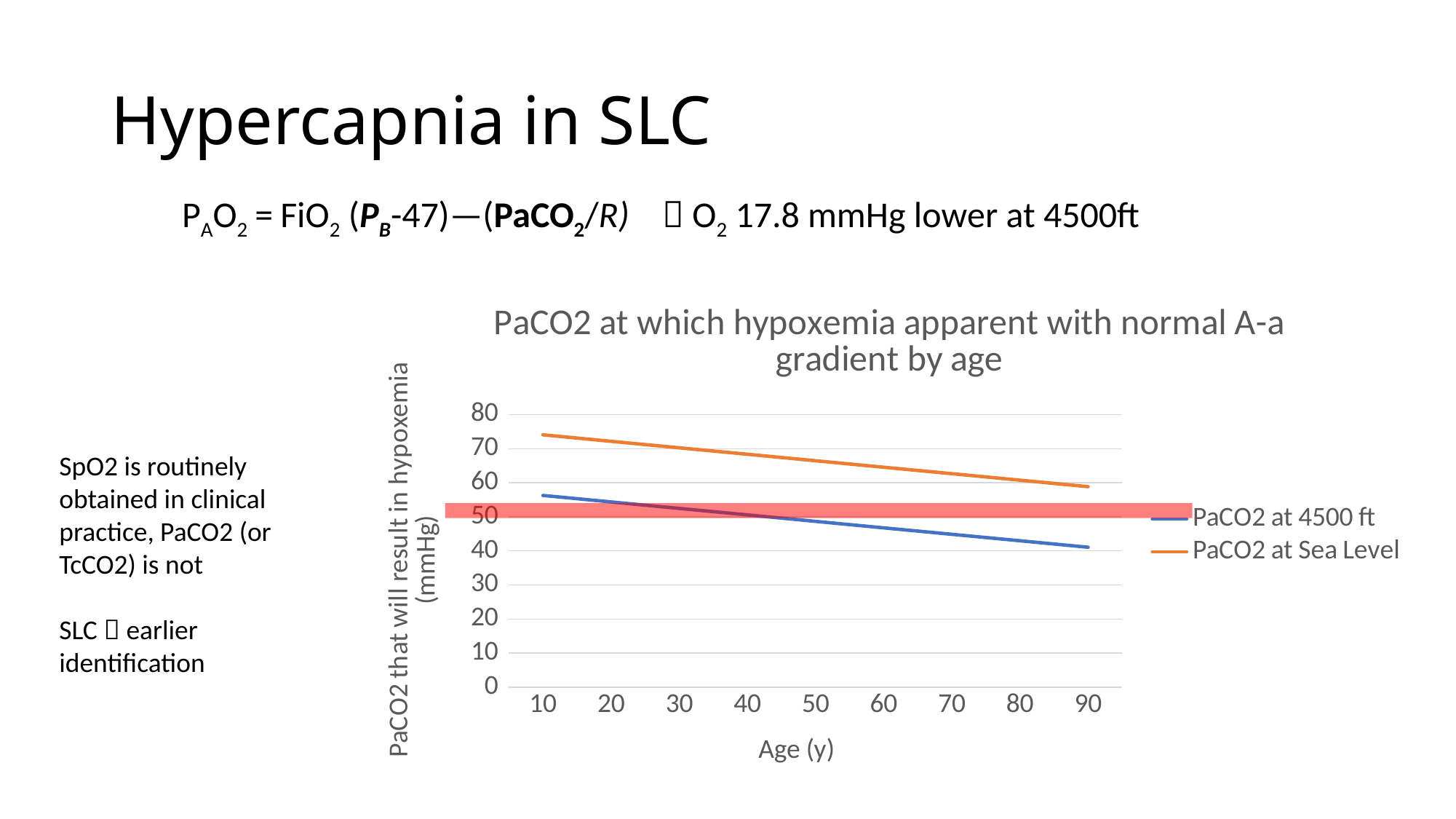
Is the value for PaCO2 at Sea Level at age 10 greater or less than 70? greater How many age values are marked along the x axis of the chart? 9 What is the title of the chart? PaCO2 at which hypoxemia apparent with normal A-a gradient by age What are the two series named in the chart legend? PaCO2 at 4500 ft and PaCO2 at Sea Level Do the values for PaCO2 at Sea Level rise or fall as age increases? fall At age 50, which series has the higher value, PaCO2 at 4500 ft or PaCO2 at Sea Level? PaCO2 at Sea Level What kind of chart is shown on the slide? line chart Is the value for PaCO2 at Sea Level at age 90 greater or less than 50? greater How many series does the chart legend list? 2 Is the value for PaCO2 at 4500 ft at age 10 greater or less than 50? greater Do the values for PaCO2 at 4500 ft rise or fall as age increases? fall